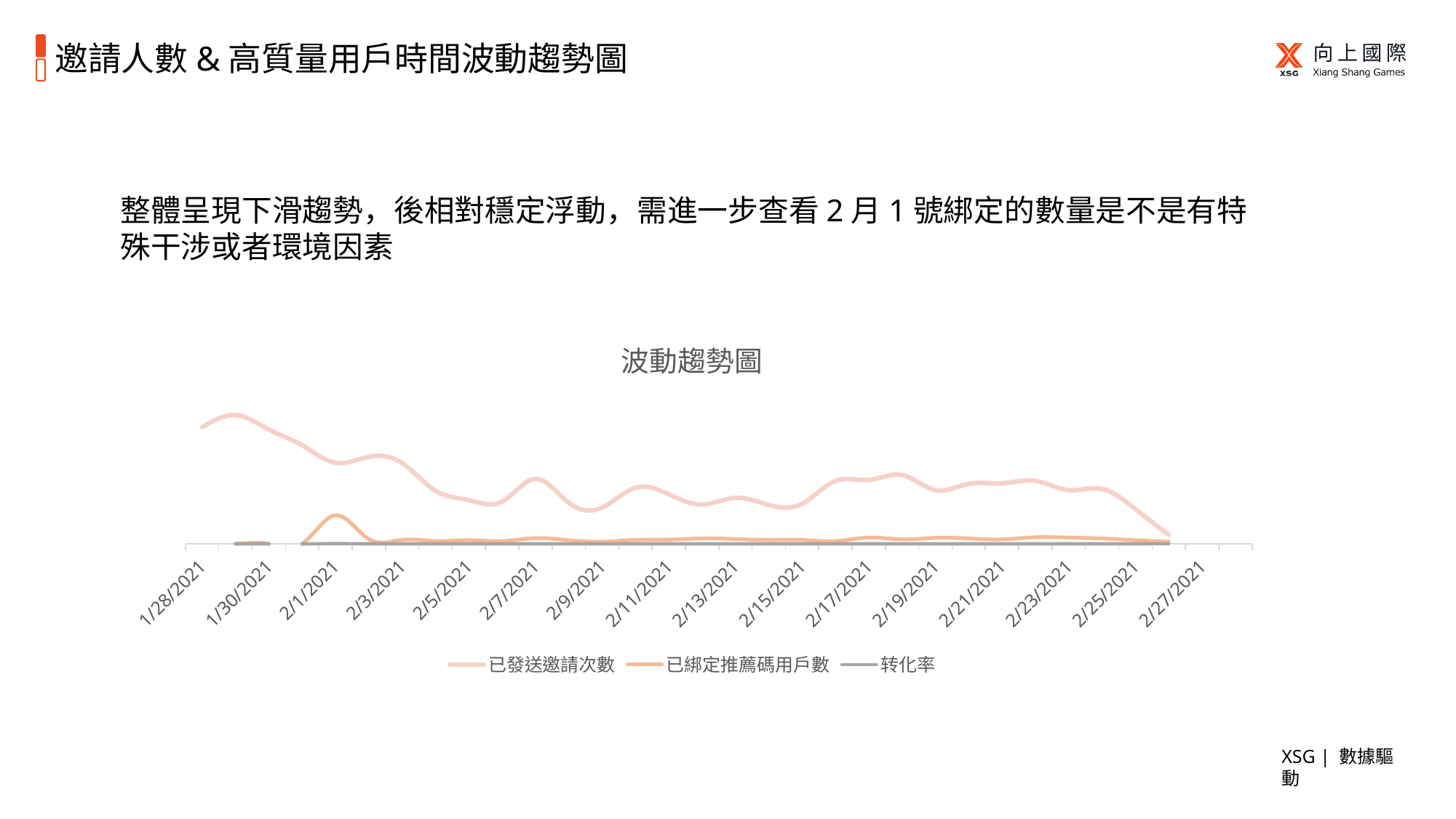
What is the title of the chart? 波動趨勢圖 On which date does the 已綁定推薦碼用戶數 line reach its highest point? 2/1/2021 Does the 已發送邀請次數 line rise or fall between 1/30/2021 and 2/5/2021? fall How many date labels are shown on the x axis? 16 Which series is shown with the darkest grey line in the legend? 转化率 What kind of chart is shown on the slide? line chart What is the last date label on the x axis? 2/27/2021 What is the first date label on the x axis? 1/28/2021 Which series has the highest values across the whole chart? 已發送邀請次數 On 2/1/2021, which series is higher: 已發送邀請次數 or 已綁定推薦碼用戶數? 已發送邀請次數 Overall, does the 已發送邀請次數 line rise or fall from the start of the chart to the end? fall How many series does the chart legend list? 3